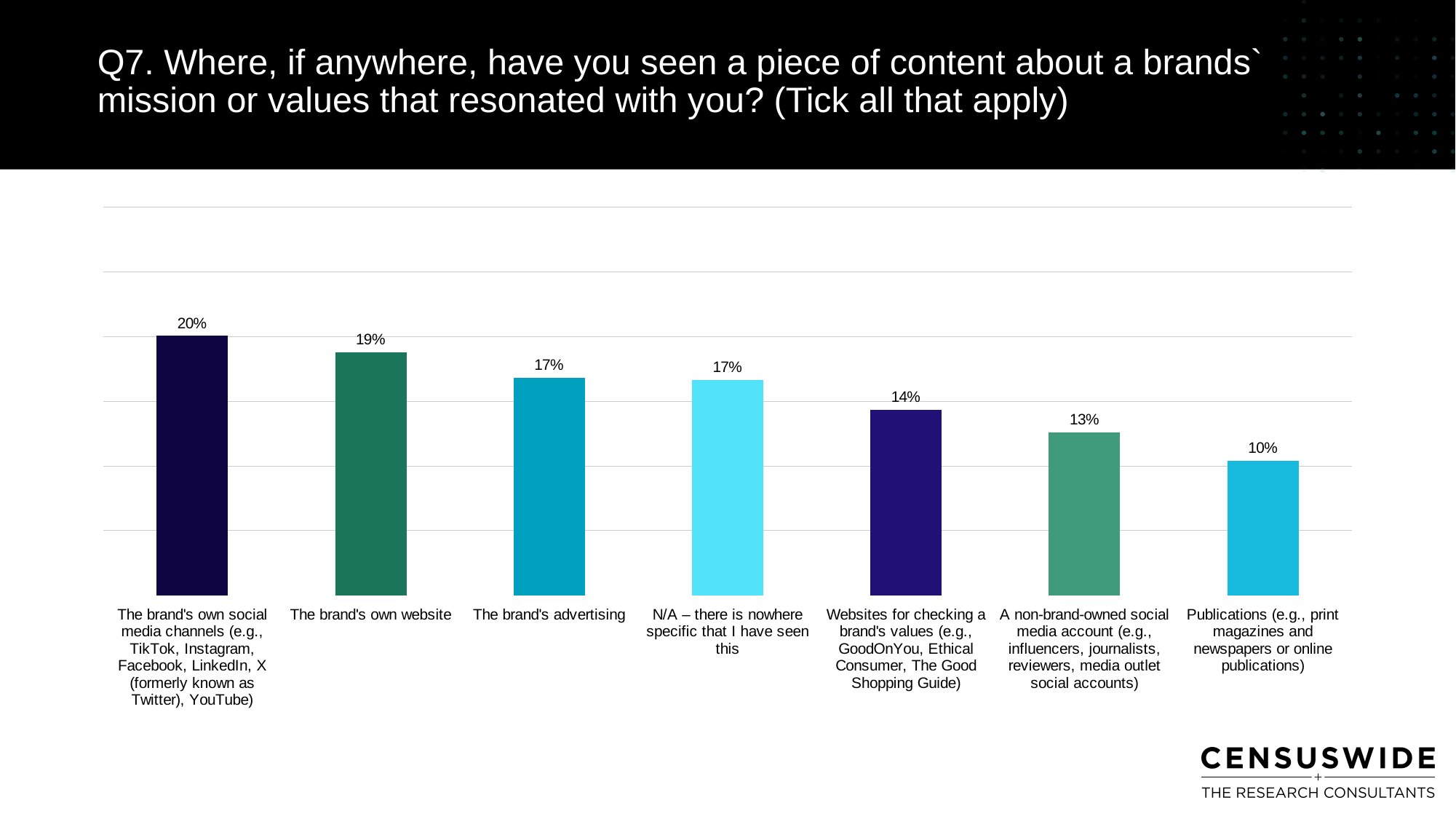
Which two categories share the same value of 17%? The brand's advertising and N/A – there is nowhere specific that I have seen this Do the values rise or fall from left to right across the categories? Fall What is the value for "Publications (e.g., print magazines and newspapers or online publications)"? 10% What is the difference between "The brand's advertising" and "A non-brand-owned social media account"? 4% What type of chart is shown on the slide? Bar chart Which is larger: "The brand's own website" or "Websites for checking a brand's values"? The brand's own website What is the difference between "The brand's own social media channels" and "Publications"? 10% What percentage is shown for "Websites for checking a brand's values"? 14% Which category has the highest value? The brand's own social media channels Which category has the lowest value? Publications What percentage of respondents selected "The brand's own website"? 19% How many categories are shown in the chart? 7